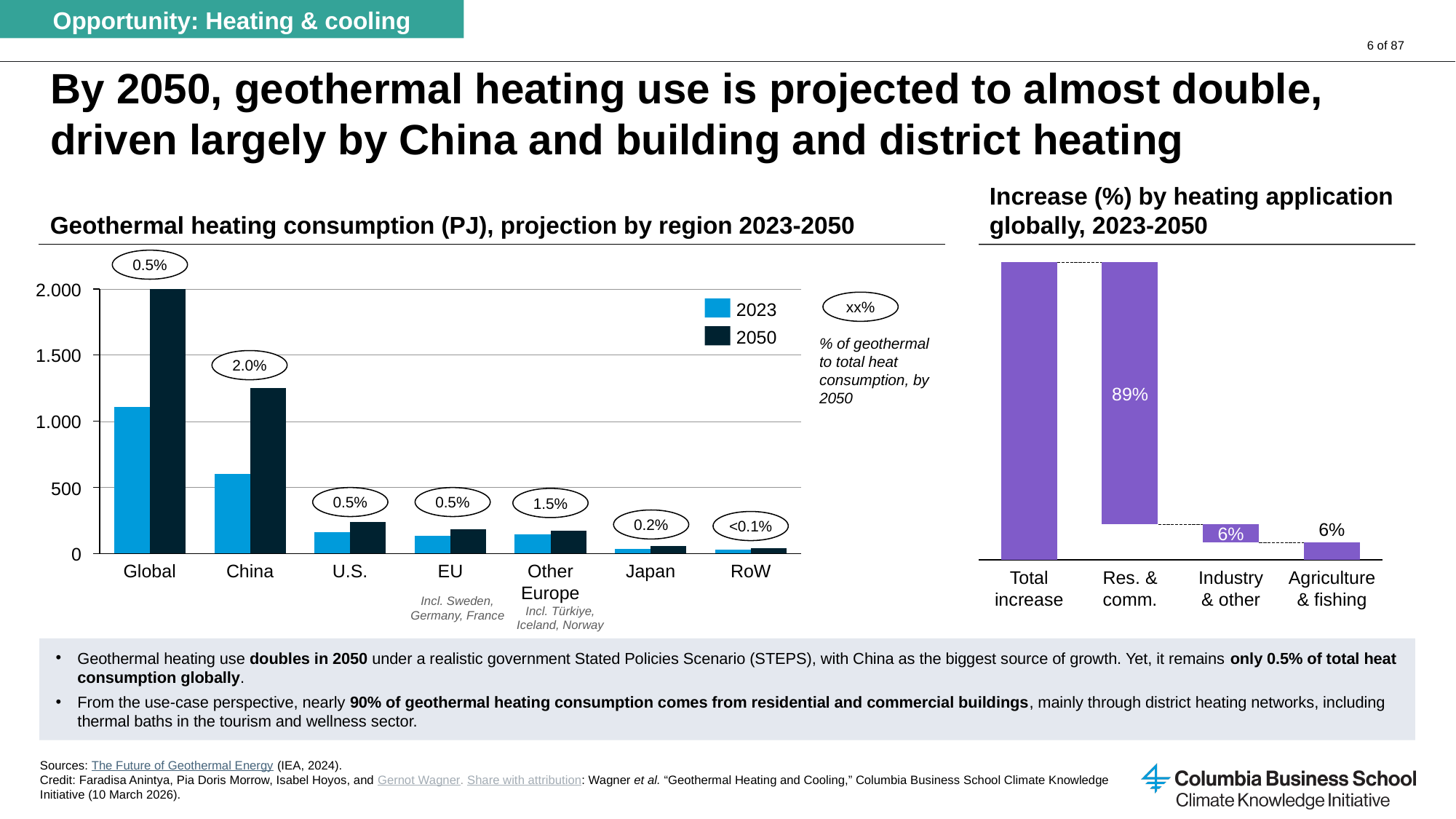
In the 'Geothermal heating consumption (PJ)' chart, is the 2023 value for Global greater or less than 1.000? greater How many regions are shown on the x axis of the 'Geothermal heating consumption (PJ)' chart? 7 In the 'Increase (%) by heating application globally, 2023-2050' chart, which heating application has the largest share of the increase? Res. & comm. In the 'Geothermal heating consumption (PJ)' chart, is the 2050 value for China greater or less than 1.000? greater In the 'Geothermal heating consumption (PJ)' chart, which is larger: the 2023 value for China or the 2023 value for the U.S.? China How many series does the legend of the 'Geothermal heating consumption (PJ)' chart list? 2 In the 'Geothermal heating consumption (PJ)' chart, which region has the highest 2050 value? Global In the 'Increase (%) by heating application globally, 2023-2050' chart, what is the value for Res. & comm.? 89% In the 'Geothermal heating consumption (PJ)' chart, is the 2050 value for the U.S. greater or less than 500? less What kind of chart is the 'Geothermal heating consumption (PJ), projection by region 2023-2050' chart? bar chart In the 'Geothermal heating consumption (PJ)' chart, what share of total heat consumption is geothermal projected to be in China by 2050? 2.0% In the 'Increase (%) by heating application globally, 2023-2050' chart, what is the value for Industry & other? 6%